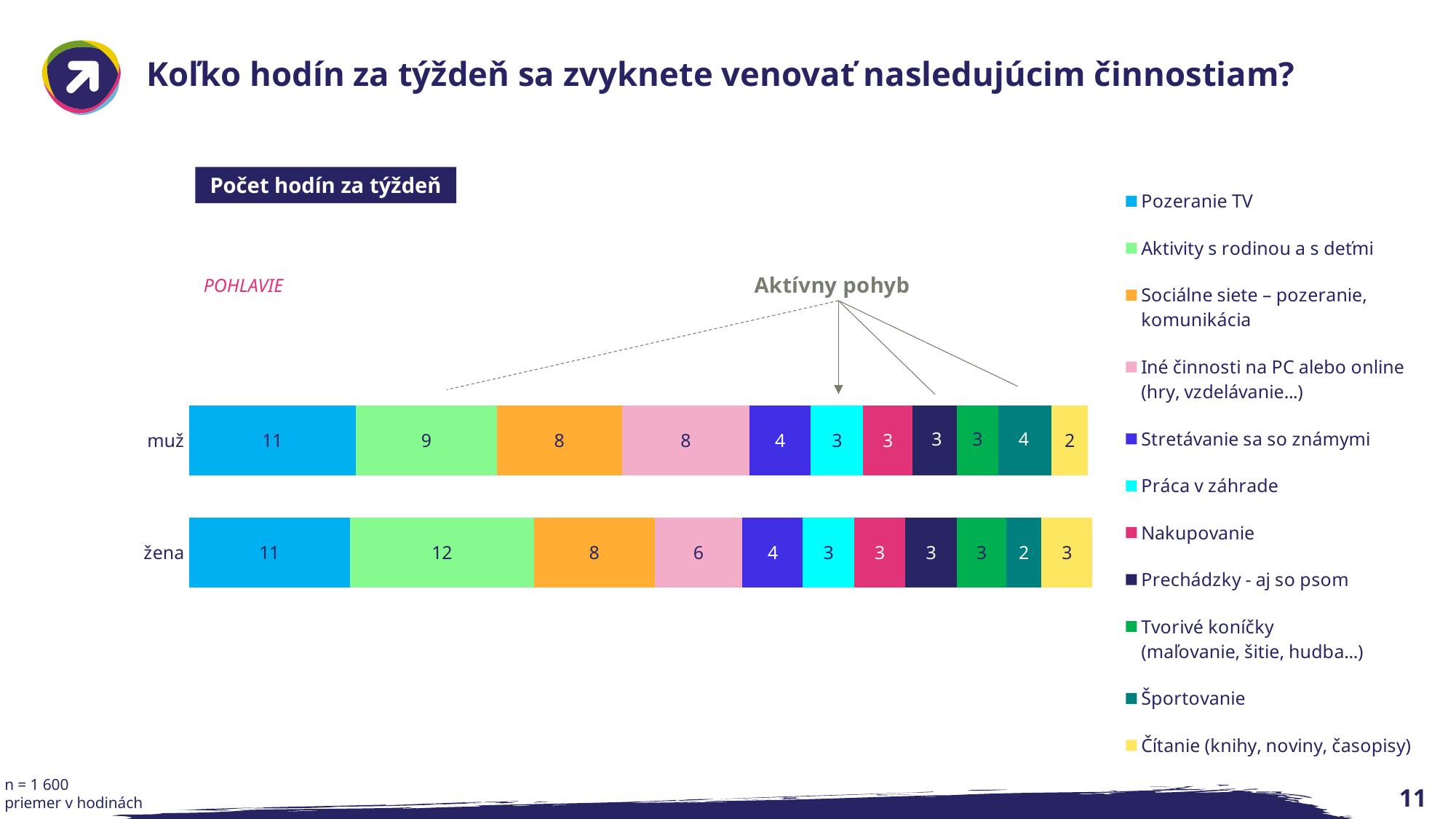
How many categories (bars) are plotted on the chart? 2 What is the value for Pozeranie TV in the muž bar? 11 What kind of chart is shown on the slide? stacked bar chart What is the total of the muž stacked bar? 58 What is the value for Športovanie in the muž bar? 4 Which segment has the highest value in the žena bar? Aktivity s rodinou a s deťmi Which is larger, the muž or the žena value for Iné činnosti na PC alebo online (hry, vzdelávanie…)? muž What is the difference between the muž and žena values for Aktivity s rodinou a s deťmi? 3 What is the value for Aktivity s rodinou a s deťmi in the žena bar? 12 How many series does the legend list? 11 What is the title shown in the box above the chart? Počet hodín za týždeň What is the value for Iné činnosti na PC alebo online (hry, vzdelávanie…) in the žena bar? 6